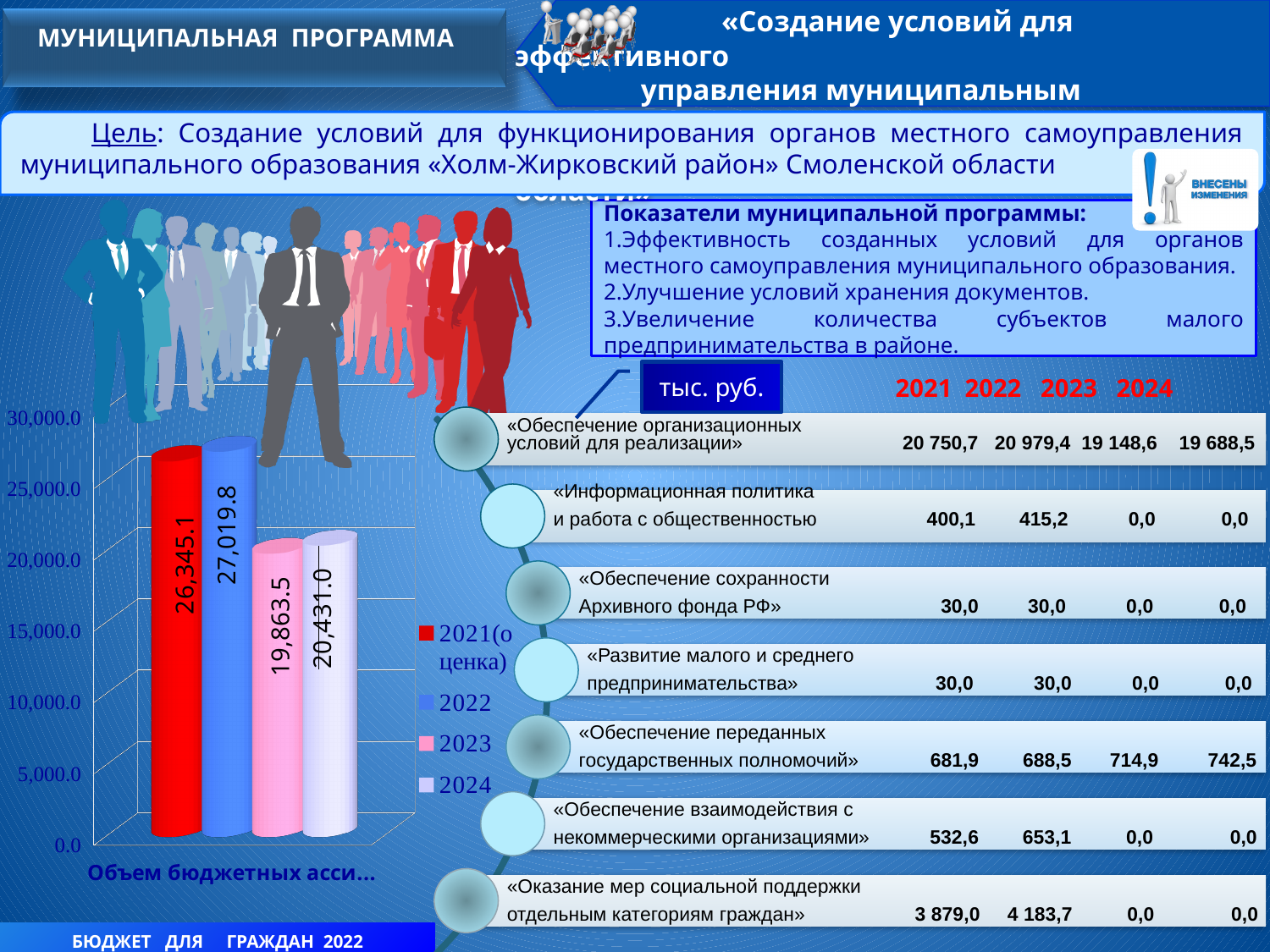
What is the difference between the 2022 and 2021(оценка) values in the chart? 674.7 What is the value of the 2023 bar in the chart? 19,863.5 What is the value of the 2022 bar in the chart? 27,019.8 Which year has the highest value in the chart? 2022 Is the value for 2021(оценка) in the chart greater or less than 25,000.0? greater What is the value of the 2024 bar in the chart? 20,431.0 What kind of chart is shown on the slide? bar chart What is the value of the 2021(оценка) bar in the chart? 26,345.1 How many series does the chart legend list? 4 Which year has the lowest value in the chart? 2023 What is the difference between the 2024 and 2023 values in the chart? 567.5 Which is larger in the chart, the value for 2024 or the value for 2023? 2024